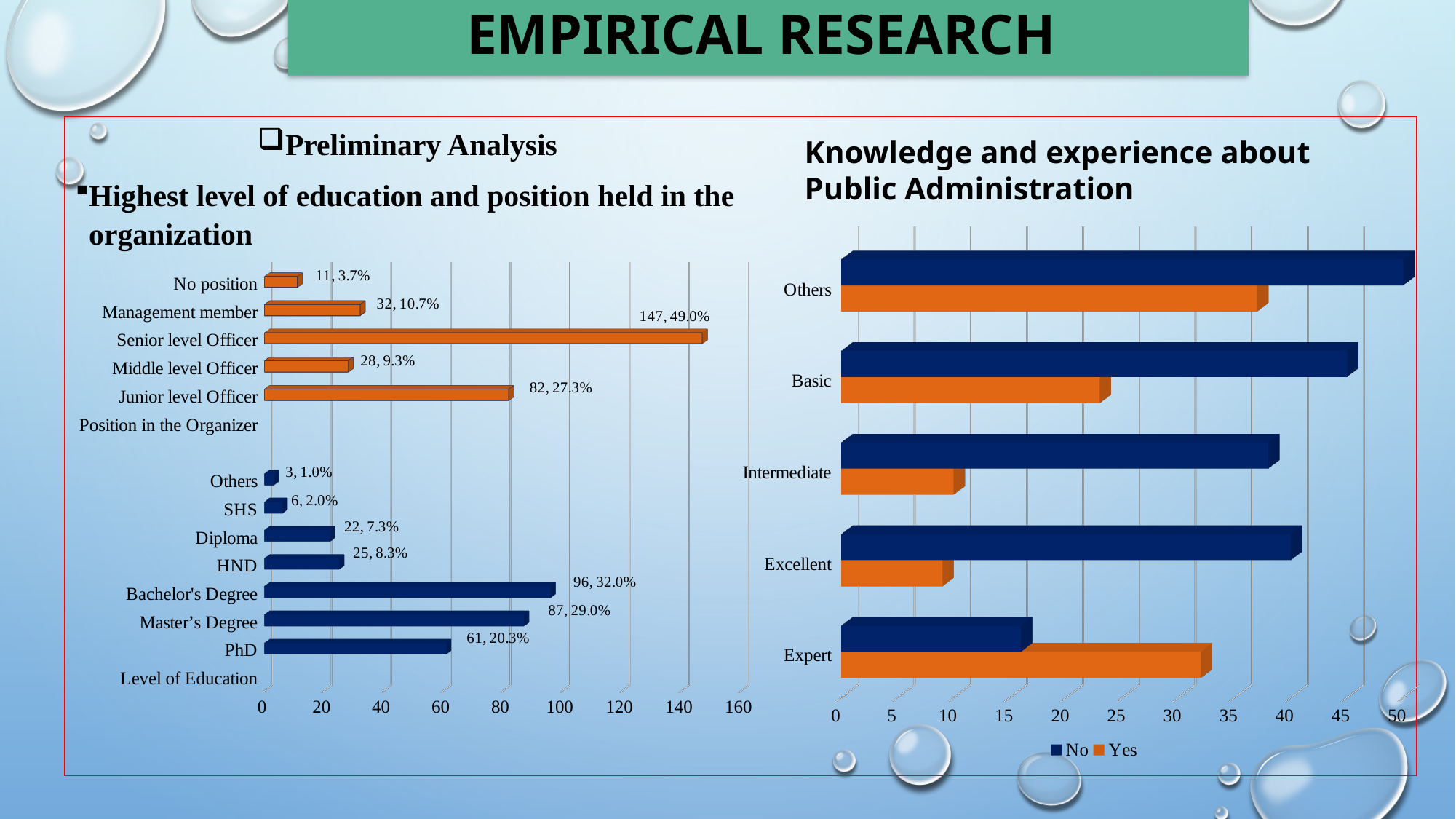
In the left chart on highest level of education and position held, which position category has the highest value? Senior level Officer In the left chart on highest level of education and position held, what is the value for Bachelor's Degree? 96, 32.0% In the right chart on knowledge and experience about Public Administration, how many series does the legend list? 2 In the left chart on highest level of education and position held, what is the difference in count between Senior level Officer and Junior level Officer? 65 In the left chart on highest level of education and position held, what is the value for Senior level Officer? 147, 49.0% In the left chart on highest level of education and position held, what is the value for PhD? 61, 20.3% In the left chart on highest level of education and position held, which is larger: Junior level Officer or Management member? Junior level Officer In the right chart on knowledge and experience about Public Administration, is the No value for Others greater or less than 45? greater In the left chart on highest level of education and position held, which level of education category has the lowest value? Others In the left chart on highest level of education and position held, what is the difference in count between Bachelor's Degree and Master's Degree? 9 In the right chart on knowledge and experience about Public Administration, is the Yes value for Expert greater or less than 30? greater In the right chart on knowledge and experience about Public Administration, which category has the lowest No value? Expert